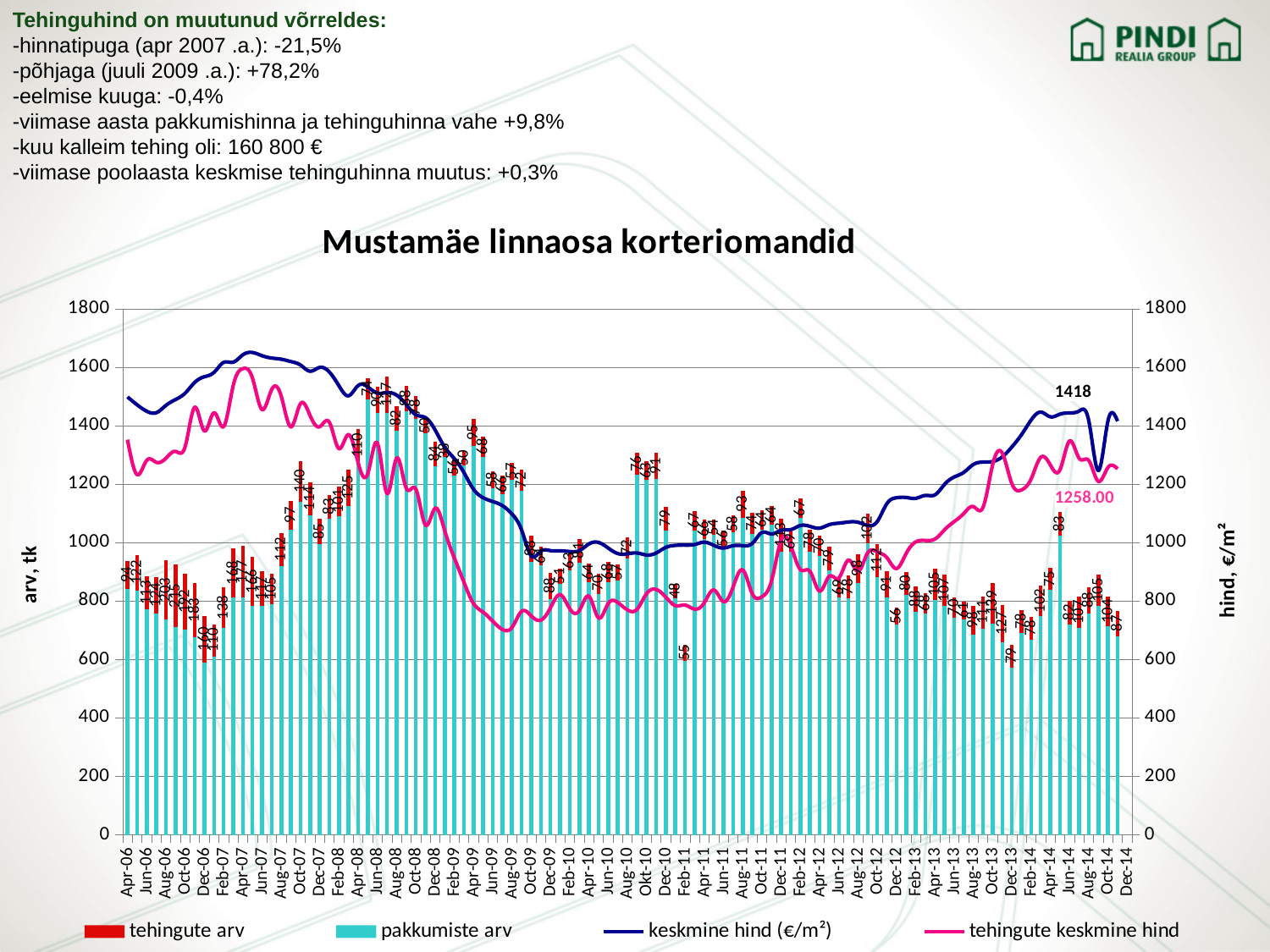
What value is labelled on the keskmine hind (€/m²) line near its 2014 peak? 1418 What is the label of the right-hand vertical axis? hind, €/m² Does the keskmine hind (€/m²) line rise or fall between Jul-09 and Jun-14? rise Is the pakkumiste arv value around Jun-08 greater or less than 1400? greater Is the keskmine hind (€/m²) value around Apr-07 greater or less than 1600? greater Is the tehingute keskmine hind value around Jul-09 greater or less than 800? less What kind of chart is shown on the slide? Combined bar and line chart What is the title of the chart? Mustamäe linnaosa korteriomandid What value is labelled on the tehingute keskmine hind line near the end of 2014? 1258.00 Which line is higher at Jun-08: keskmine hind (€/m²) or tehingute keskmine hind? keskmine hind (€/m²) How many series does the chart legend list? 4